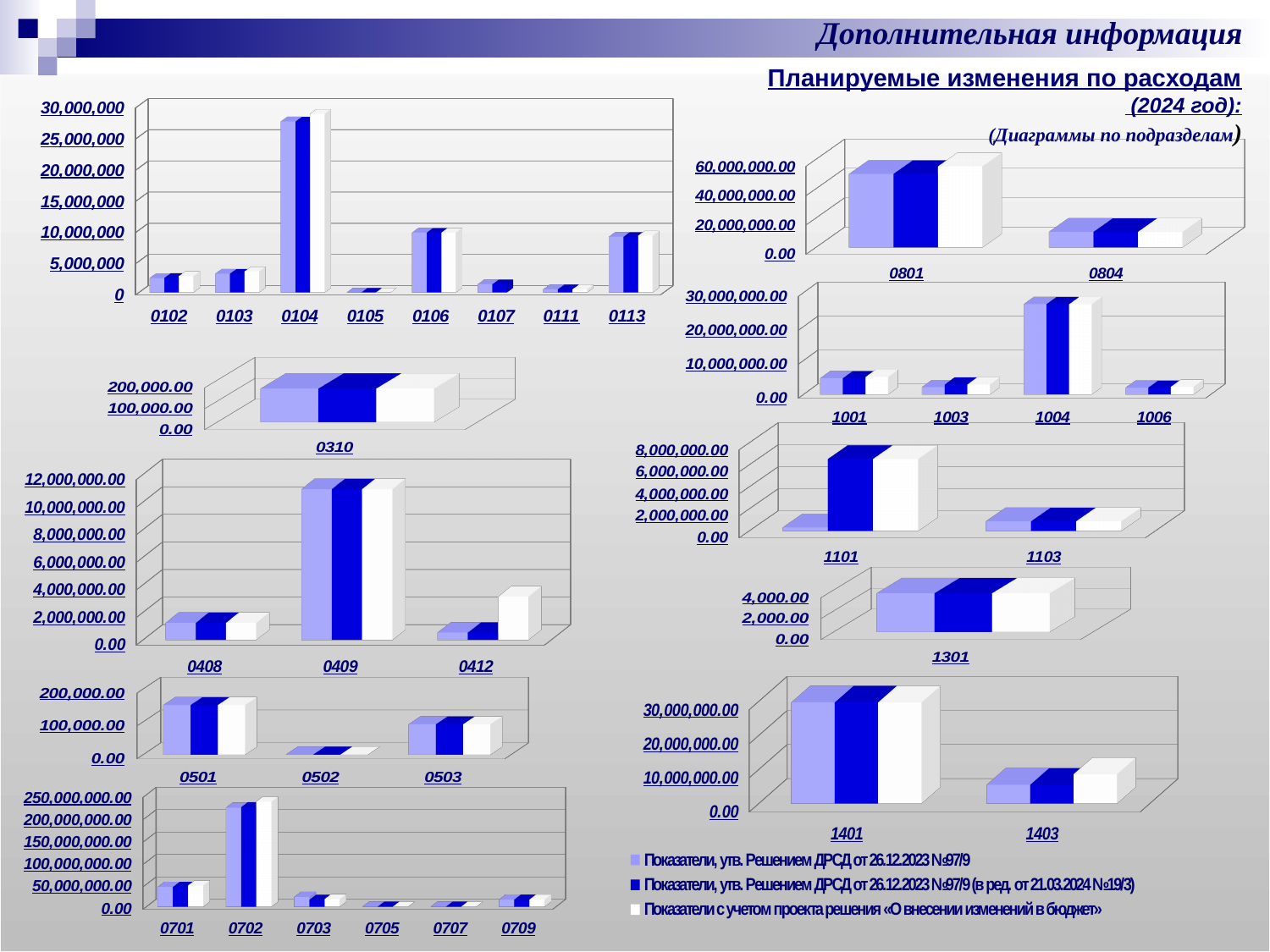
In the top-left chart, is the value for 0104 greater or less than 25,000,000? greater How many categories are shown in the chart with categories 0701 through 0709? 6 How many categories are shown in the top-left chart (0102 to 0113)? 8 In the chart with categories 0408, 0409 and 0412, which category has the highest value? 0409 In the chart with categories 0408, 0409 and 0412, is the value for 0409 greater or less than 10,000,000.00? greater In the chart with categories 0801 and 0804, which category has the larger value? 0801 In the chart with categories 1401 and 1403, is the value for 1403 greater or less than 20,000,000.00? less What type of chart is used for the chart with categories 0501, 0502 and 0503? Bar chart In the chart with categories 1001, 1003, 1004 and 1006, which category has the highest value? 1004 In the chart with categories 0701 through 0709, which category has the highest value? 0702 How many series does the legend at the bottom right of the slide list? 3